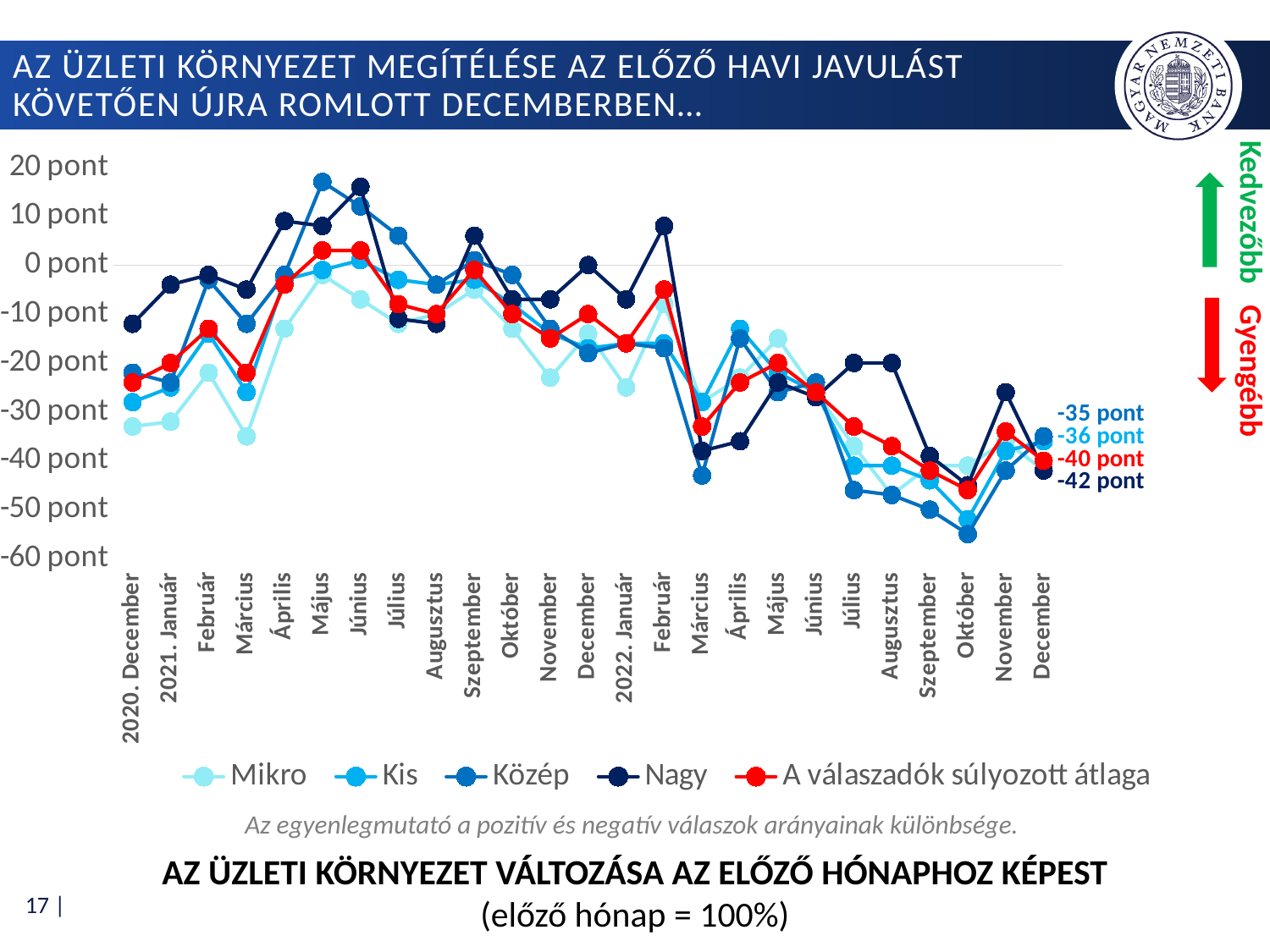
Which series is drawn in red? A válaszadók súlyozott átlaga What is the value of 'A válaszadók súlyozott átlaga' in 2022 December? -40 pont Which of the labelled series has the highest value in 2022 December? Közép How many series does the legend list? 5 What is the value of the 'Közép' series in 2022 December? -35 pont What is the value of the 'Kis' series in 2022 December? -36 pont How many months are plotted along the x axis? 25 Does 'A válaszadók súlyozott átlaga' rise or fall from 2022 Február to 2022 Március? fall What is the difference between the 'Közép' and 'Nagy' values in 2022 December? 7 pont What kind of chart is shown on the slide? line chart Is the value for 'Közép' in 2021 Május greater or less than 10 pont? greater What is the value of the 'Nagy' series in 2022 December? -42 pont